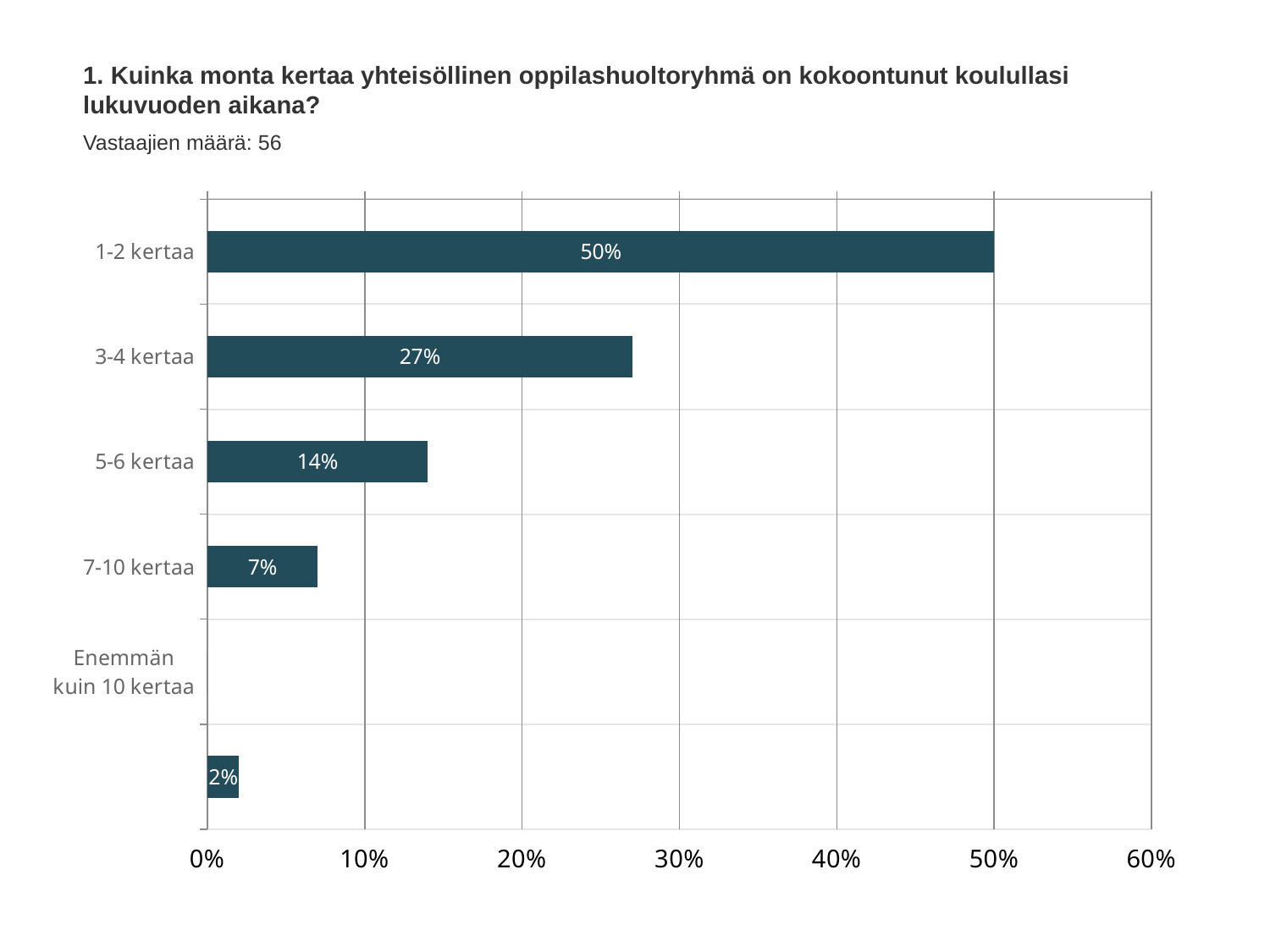
What is the value for "1-2 kertaa"? 50% What is the value for "5-6 kertaa"? 14% What is the value for "7-10 kertaa"? 7% Which category has the highest value? 1-2 kertaa Which labelled category has no bar drawn at all? Enemmän kuin 10 kertaa What is the difference between the values for "1-2 kertaa" and "3-4 kertaa"? 23% What is the value for "3-4 kertaa"? 27% What is the difference between the values for "5-6 kertaa" and "7-10 kertaa"? 7% What kind of chart is shown on the slide? bar chart Is the value for "3-4 kertaa" greater or less than 20%? greater Which is larger, the value for "3-4 kertaa" or the value for "5-6 kertaa"? 3-4 kertaa How many respondents (Vastaajien määrä) does the slide report? 56